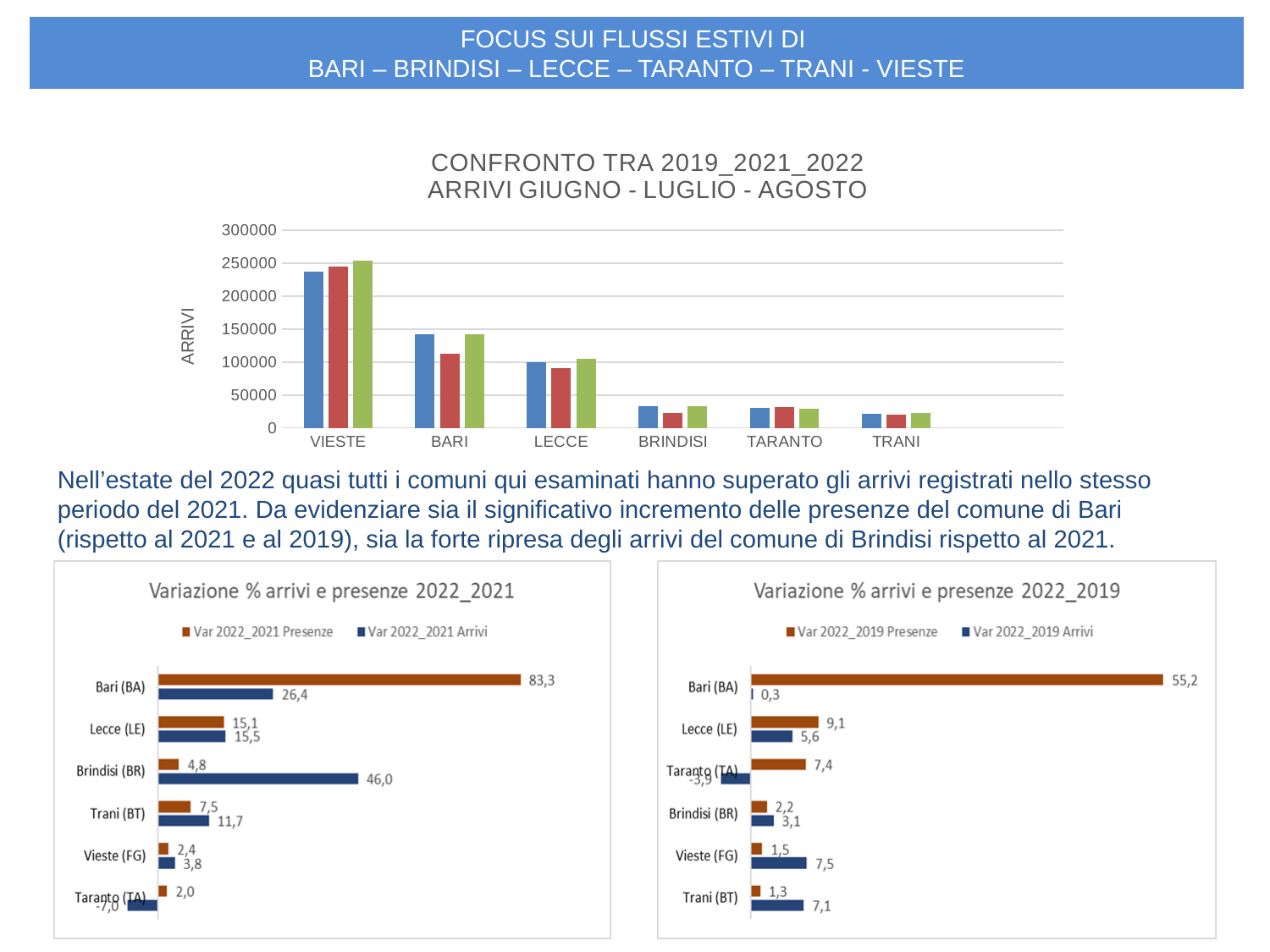
In the top chart 'CONFRONTO TRA 2019_2021_2022', which comune has the highest arrivals? VIESTE In the bottom-right chart 'Variazione % arrivi e presenze 2022_2019', what is the Var 2022_2019 Arrivi value for Bari (BA)? 0,3 In the bottom-left chart 'Variazione % arrivi e presenze 2022_2021', what is the difference between the Presenze and Arrivi values for Bari (BA)? 56,9 In the top chart 'CONFRONTO TRA 2019_2021_2022', are the values for VIESTE greater or less than 200000? greater How many series does the legend of the bottom-left chart 'Variazione % arrivi e presenze 2022_2021' list? 2 In the top chart 'CONFRONTO TRA 2019_2021_2022', how many comuni (categories) are shown on the x axis? 6 In the bottom-left chart 'Variazione % arrivi e presenze 2022_2021', what is the Var 2022_2021 Presenze value for Bari (BA)? 83,3 In the bottom-left chart 'Variazione % arrivi e presenze 2022_2021', what is the Var 2022_2021 Arrivi value for Brindisi (BR)? 46,0 What kind of chart is the top chart titled 'CONFRONTO TRA 2019_2021_2022 ARRIVI GIUGNO - LUGLIO - AGOSTO'? bar chart In the top chart 'CONFRONTO TRA 2019_2021_2022', which comune has the lowest arrivals? TRANI In the top chart 'CONFRONTO TRA 2019_2021_2022', are the values for BRINDISI greater or less than 50000? less In the bottom-right chart 'Variazione % arrivi e presenze 2022_2019', which is larger for Vieste (FG): the Presenze value or the Arrivi value? Arrivi (7,5)